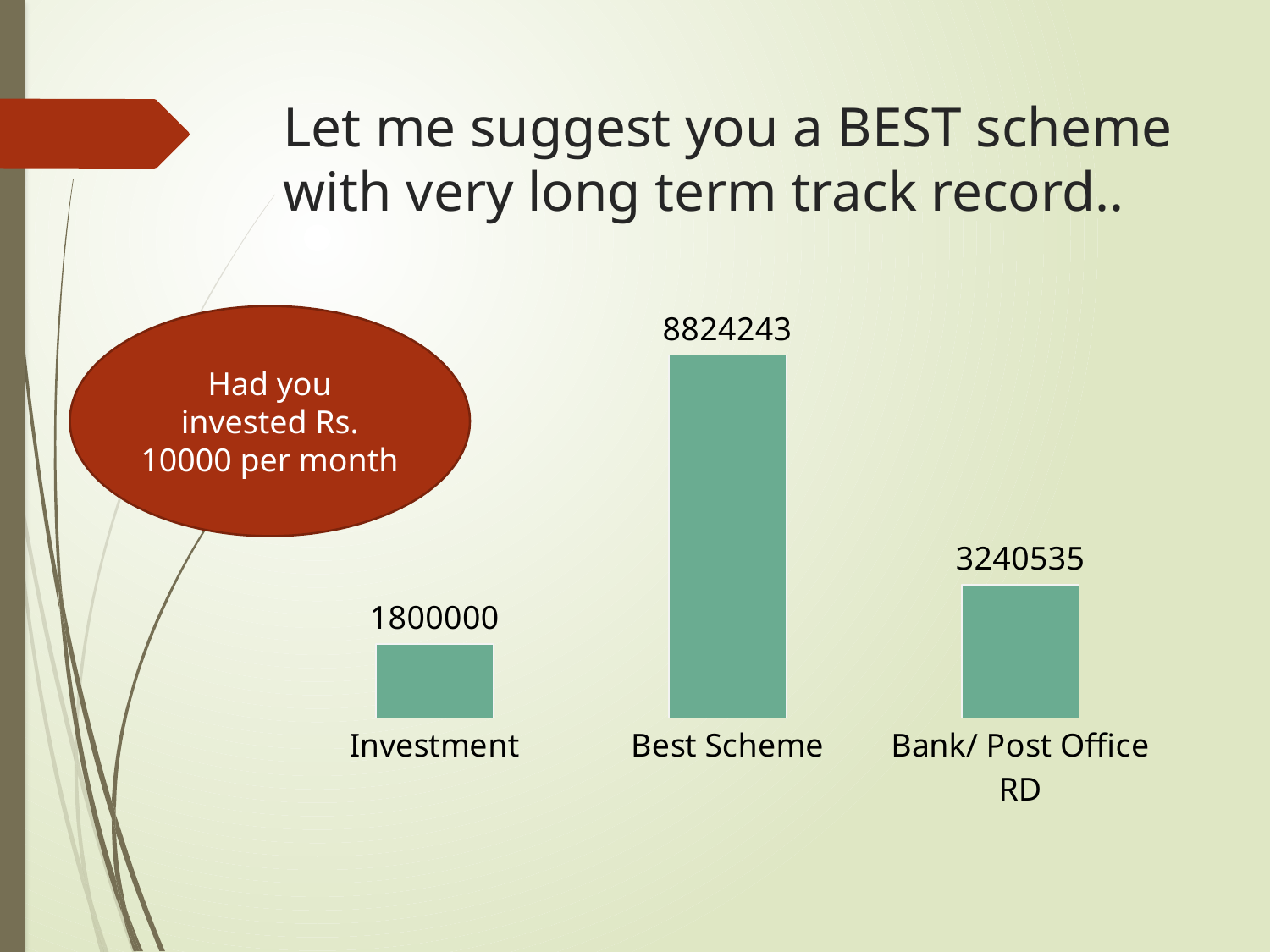
What monthly investment amount does the red oval on the slide mention? Rs. 10000 per month What is the difference between the Bank/ Post Office RD value and the Investment value? 1440535 What is the value for Investment? 1800000 Which category has the highest value? Best Scheme Which is larger, the value for Best Scheme or the value for Bank/ Post Office RD? Best Scheme Which category has the lowest value? Investment How many categories are shown in the chart? 3 Which is larger, the value for Investment or the value for Bank/ Post Office RD? Bank/ Post Office RD What kind of chart is shown on the slide? Bar chart What is the value for Best Scheme? 8824243 What is the value for Bank/ Post Office RD? 3240535 What is the difference between the Best Scheme value and the Bank/ Post Office RD value? 5583708